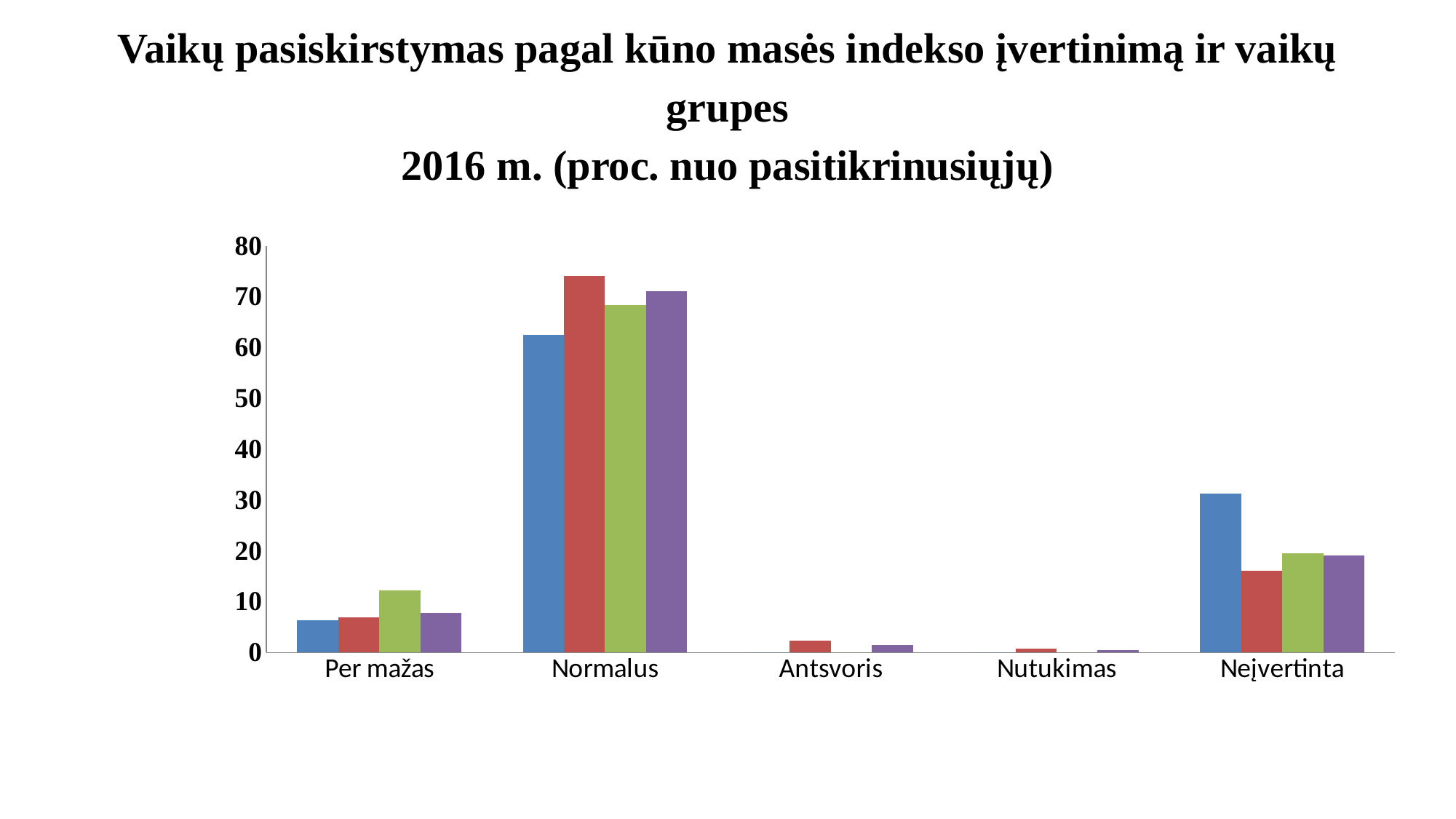
Is the value of the red bar for Neįvertinta greater or less than 20? less Which category has the highest bars overall? Normalus For the Normalus category, which is larger: the red bar or the blue bar? the red bar What kind of chart is shown on the slide? bar chart How many categories are shown on the x axis? 5 Is the value of the blue bar for Neįvertinta greater or less than 20? greater Is the value of the red bar for Normalus greater or less than 70? greater How many bars (series) are plotted for the Normalus category? 4 For the Neįvertinta category, which is larger: the blue bar or the red bar? the blue bar What year is given in the chart title? 2016